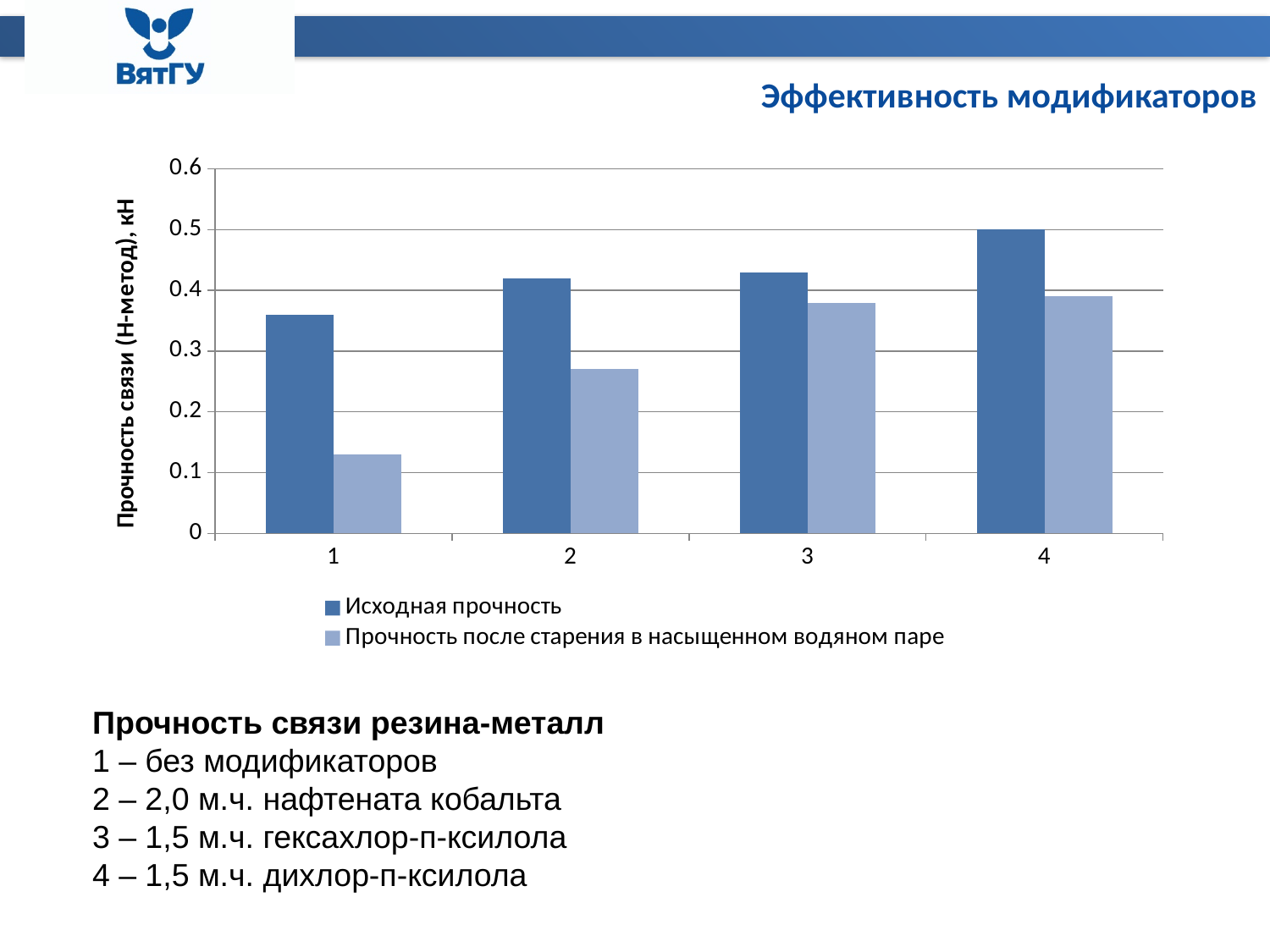
Do the values of "Прочность после старения в насыщенном водяном паре" rise or fall from category 1 to category 4? rise Is the value of "Прочность после старения в насыщенном водяном паре" for category 1 greater or less than 0.2? less How many series does the chart's legend list? 2 Which category has the lowest value for the series "Прочность после старения в насыщенном водяном паре"? 1 For category 1, which series has the larger value: "Исходная прочность" or "Прочность после старения в насыщенном водяном паре"? Исходная прочность What is the value of "Исходная прочность" for category 4? 0.5 How many categories are shown on the x axis of the chart? 4 What kind of chart is shown on the slide? bar chart Which category has the highest value for the series "Исходная прочность"? 4 What is the title of the chart's vertical axis? Прочность связи (Н-метод), кН Is the value of "Прочность после старения в насыщенном водяном паре" for category 2 greater or less than 0.3? less Is the value of "Исходная прочность" for category 1 greater or less than 0.3? greater